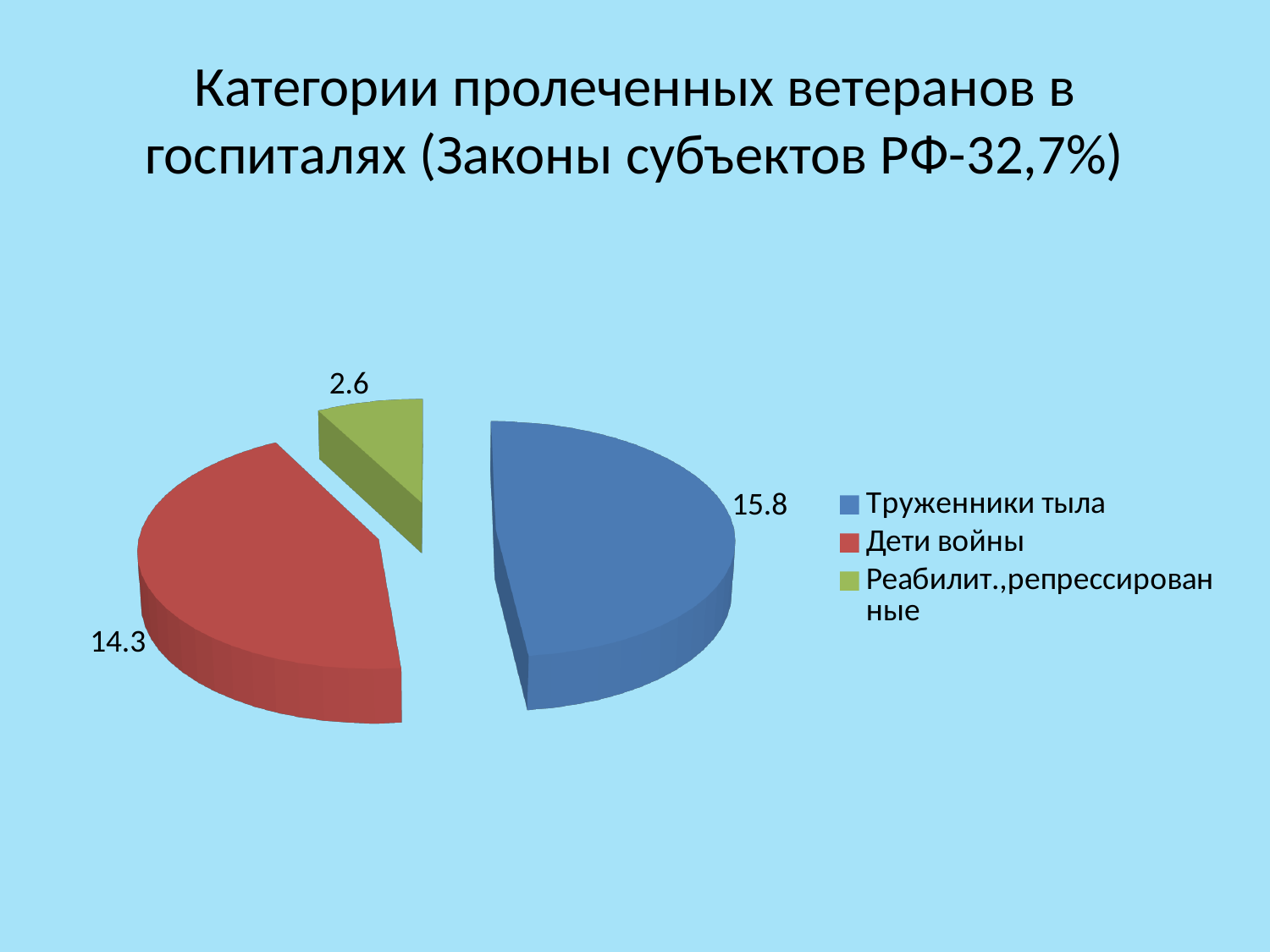
What is the difference between the values for Труженники тыла and Дети войны? 1.5 What colour is the Дети войны slice in the pie chart? Red What value is shown for the Дети войны slice? 14.3 Which category has the smallest slice of the pie? Реабилит.,репрессированные What kind of chart is shown on the slide? Pie chart How many categories are shown in the pie chart? 3 What is the difference between the values for Дети войны and Реабилит.,репрессированные? 11.7 What is the total of the three values shown in the pie chart? 32.7 What value is shown for the Труженники тыла slice? 15.8 Which is larger, the value for Труженники тыла or the value for Дети войны? Труженники тыла Which category has the largest slice of the pie? Труженники тыла What value is shown for the Реабилит.,репрессированные slice? 2.6